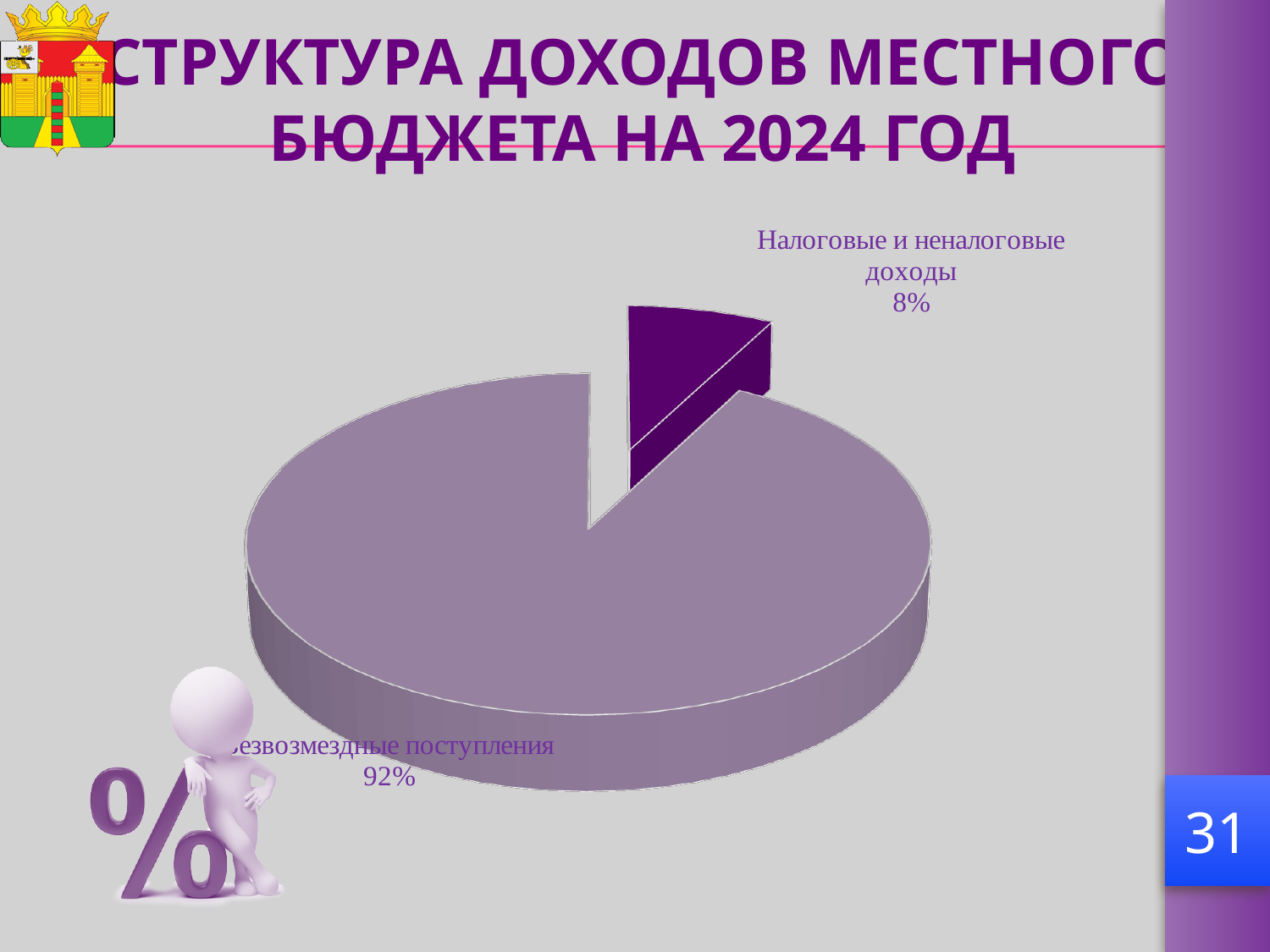
How many slices does the pie chart have? 2 Which slice of the pie is the largest? Безвозмездные поступления Is the share for "Налоговые и неналоговые доходы" greater or less than 10%? less What kind of chart is shown on the slide? Pie chart What share of the pie does "Безвозмездные поступления" have? 92% What share of the pie does "Налоговые и неналоговые доходы" have? 8% What is the title of the slide containing the pie chart? СТРУКТУРА ДОХОДОВ МЕСТНОГО БЮДЖЕТА НА 2024 ГОД What is the difference in percentage points between "Безвозмездные поступления" and "Налоговые и неналоговые доходы"? 84 percentage points Which slice of the pie is drawn in dark purple and pulled out from the rest? Налоговые и неналоговые доходы Which slice of the pie is the smallest? Налоговые и неналоговые доходы Which is larger: "Налоговые и неналоговые доходы" or "Безвозмездные поступления"? Безвозмездные поступления Is the share for "Безвозмездные поступления" greater or less than 90%? greater